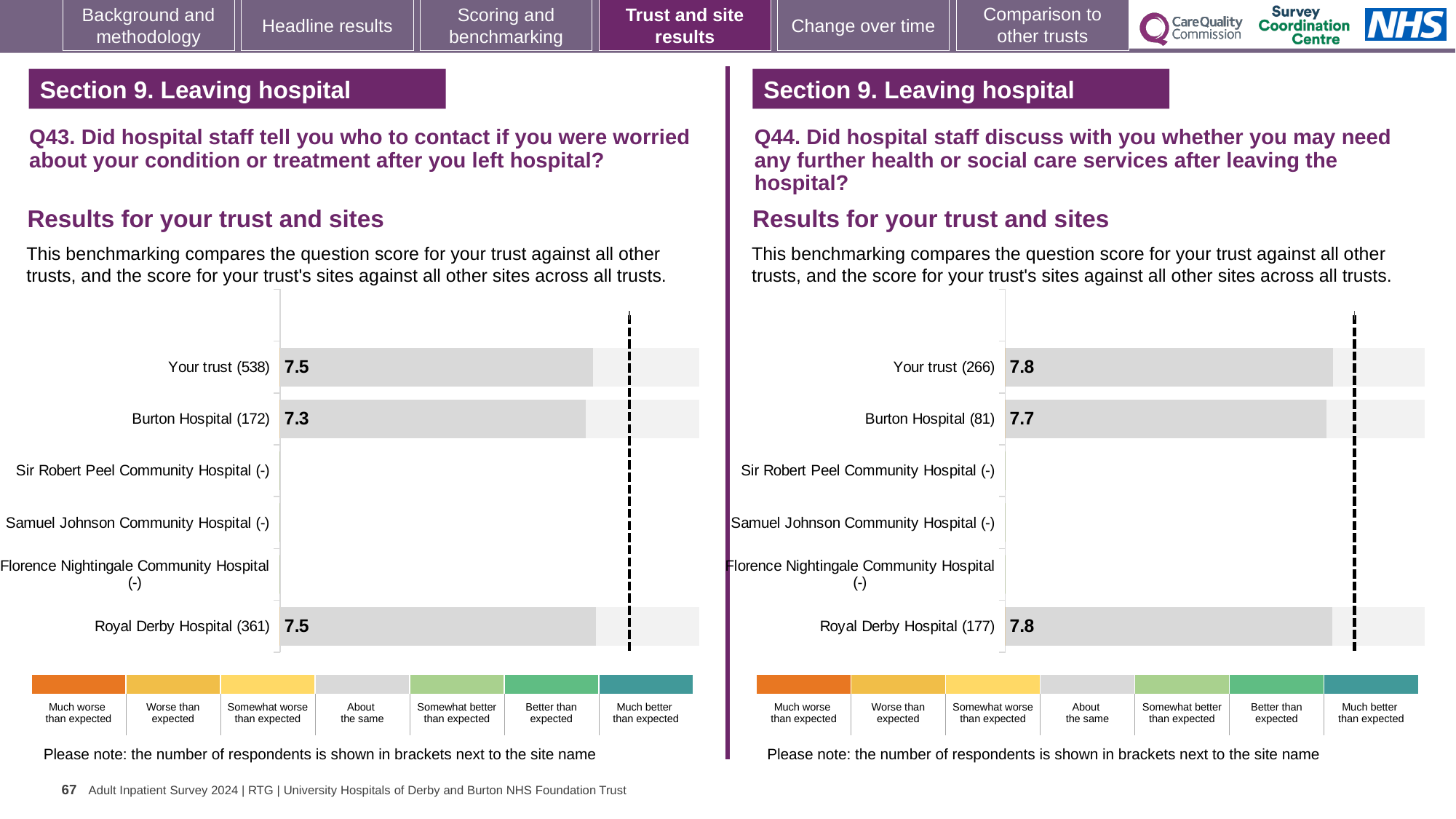
On the Q44 chart (right), which is larger, the score for Your trust or the score for Burton Hospital? Your trust On the Q44 chart (right), what is the score for Royal Derby Hospital? 7.8 On the Q44 chart (right), which site with a printed score has the lowest score? Burton Hospital On the Q43 chart (left), what is the difference between the scores for Your trust and Burton Hospital? 0.2 On the Q44 chart (right), what is the score for Your trust? 7.8 What kind of chart is used on the Q44 chart (right)? Bar chart On the Q43 chart (left), what is the score for Your trust? 7.5 On the Q43 chart (left), what is the score for Burton Hospital? 7.3 On the Q43 chart (left), which site with a printed score has the lowest score? Burton Hospital On the Q44 chart (right), what is the score for Burton Hospital? 7.7 How many site/trust categories are listed on the Q43 chart (left)? 6 On the Q43 chart (left), what is the score for Royal Derby Hospital? 7.5